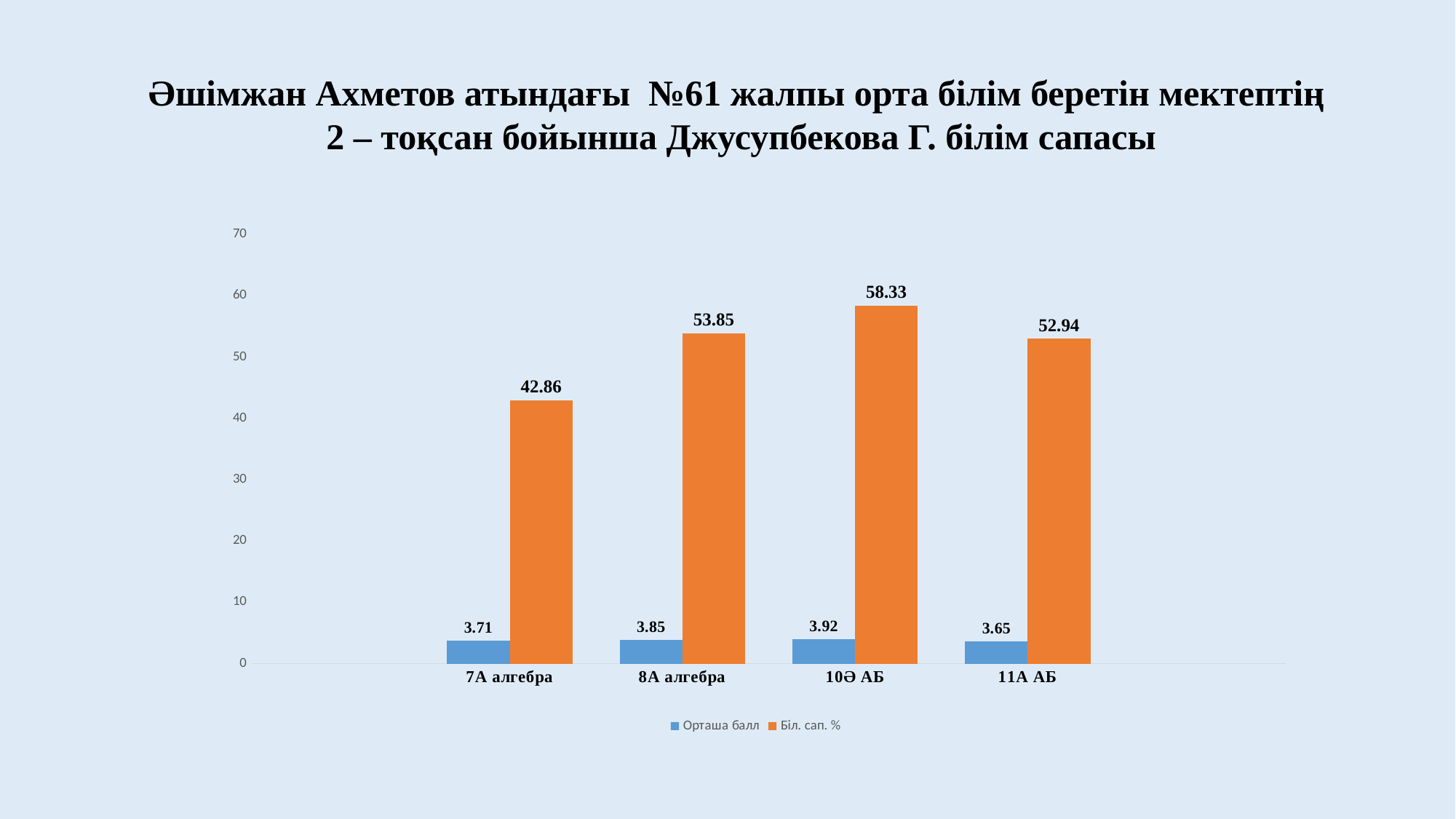
Which category has the highest Біл. сап. % value? 10Ә АБ What is the Біл. сап. % value for 10Ә АБ? 58.33 What is the difference between the Біл. сап. % values for 8А алгебра and 7А алгебра? 10.99 Which colour represents the Біл. сап. % series? orange What is the Орташа балл value for 7А алгебра? 3.71 Which category has the lowest Орташа балл value? 11А АБ What is the Біл. сап. % value for 11А АБ? 52.94 How many categories are shown on the x axis? 4 What kind of chart is shown on the slide? bar chart How many series does the legend list? 2 Which is larger, the Орташа балл for 8А алгебра or for 10Ә АБ? 10Ә АБ Is the Біл. сап. % value for 7А алгебра greater or less than 50? less